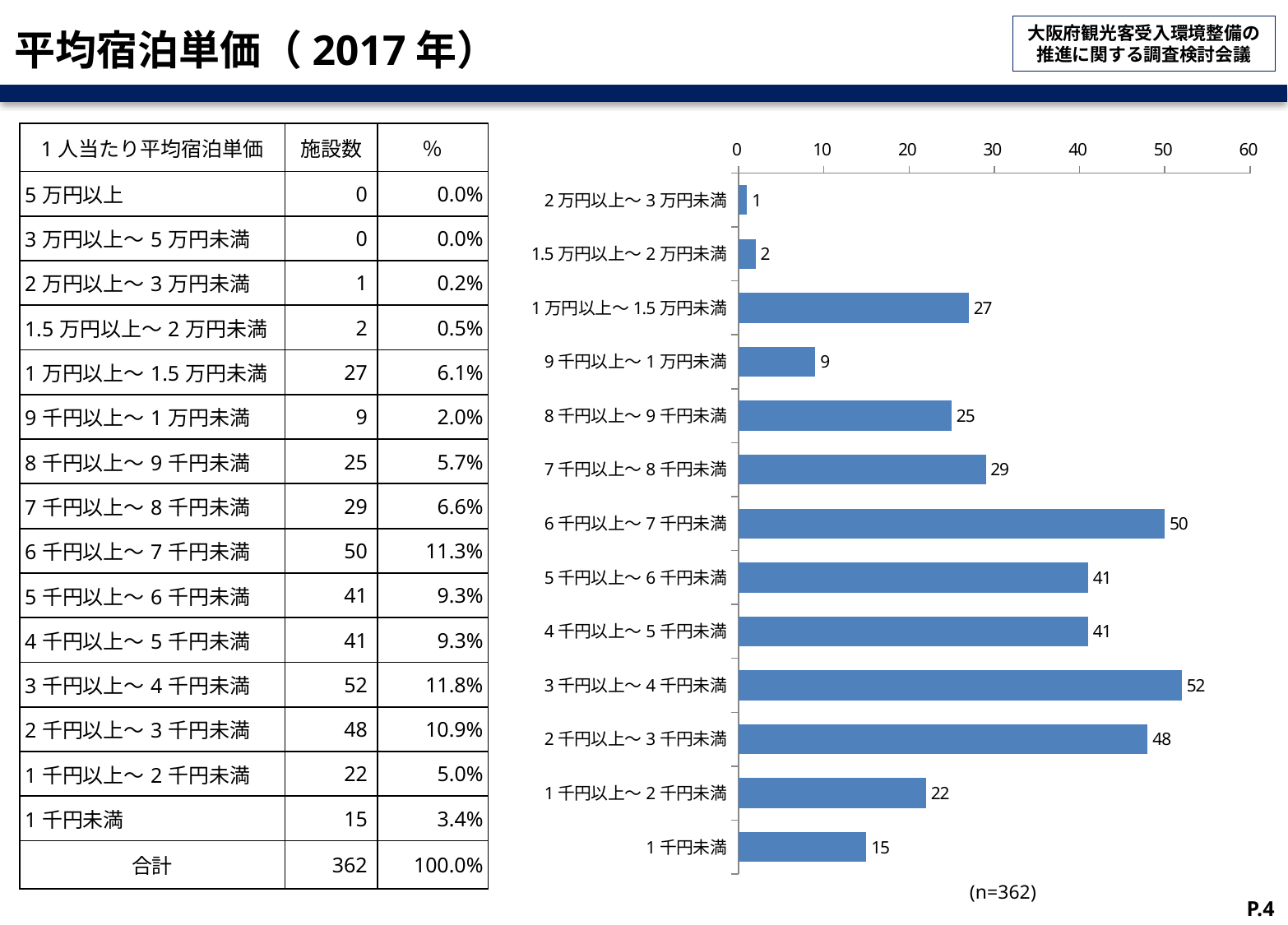
What sample size (n) is noted below the bar chart? n=362 Is the value for 5千円以上～6千円未満 greater or less than 40 in the bar chart? greater What is the value for 1千円未満 in the bar chart? 15 What is the value for 1万円以上～1.5万円未満 in the bar chart? 27 What is the value for 6千円以上～7千円未満 in the bar chart? 50 Which category has the lowest value in the bar chart? 2万円以上～3万円未満 How many categories are shown in the bar chart? 13 What is the difference between the values for 1千円以上～2千円未満 and 1千円未満 in the bar chart? 7 What kind of chart is shown on the slide? bar chart Which is larger in the bar chart: the value for 7千円以上～8千円未満 or the value for 8千円以上～9千円未満? 7千円以上～8千円未満 Which category has the highest value in the bar chart? 3千円以上～4千円未満 What is the difference between the values for 3千円以上～4千円未満 and 2千円以上～3千円未満 in the bar chart? 4